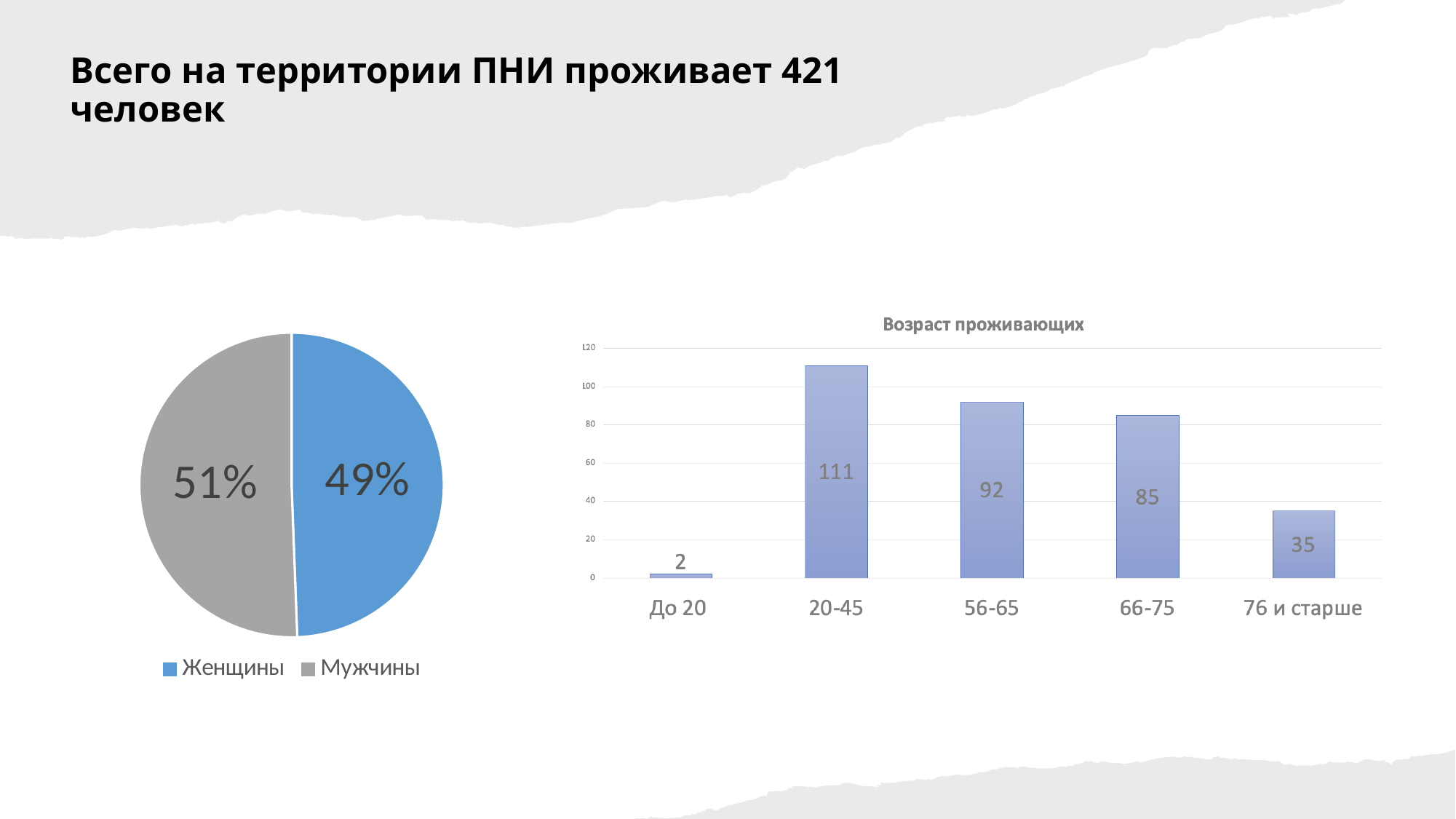
In the chart titled 'Возраст проживающих', is the value for 66-75 greater or less than 80? greater What kind of chart is the chart titled 'Возраст проживающих'? Bar chart In the chart titled 'Возраст проживающих', which category has the lowest value? До 20 In the pie chart on the left, what share is labelled for Женщины? 49% In the chart titled 'Возраст проживающих', what is the value for the 76 и старше category? 35 In the pie chart on the left, how many entries does the legend list? 2 In the pie chart on the left, what share is labelled for Мужчины? 51% In the chart titled 'Возраст проживающих', what is the difference between the values for 56-65 and 66-75? 7 In the chart titled 'Возраст проживающих', what is the value for the 20-45 category? 111 In the chart titled 'Возраст проживающих', how many age categories are shown on the x axis? 5 In the chart titled 'Возраст проживающих', which category has the highest value? 20-45 In the pie chart on the left, which slice is larger, Женщины or Мужчины? Мужчины